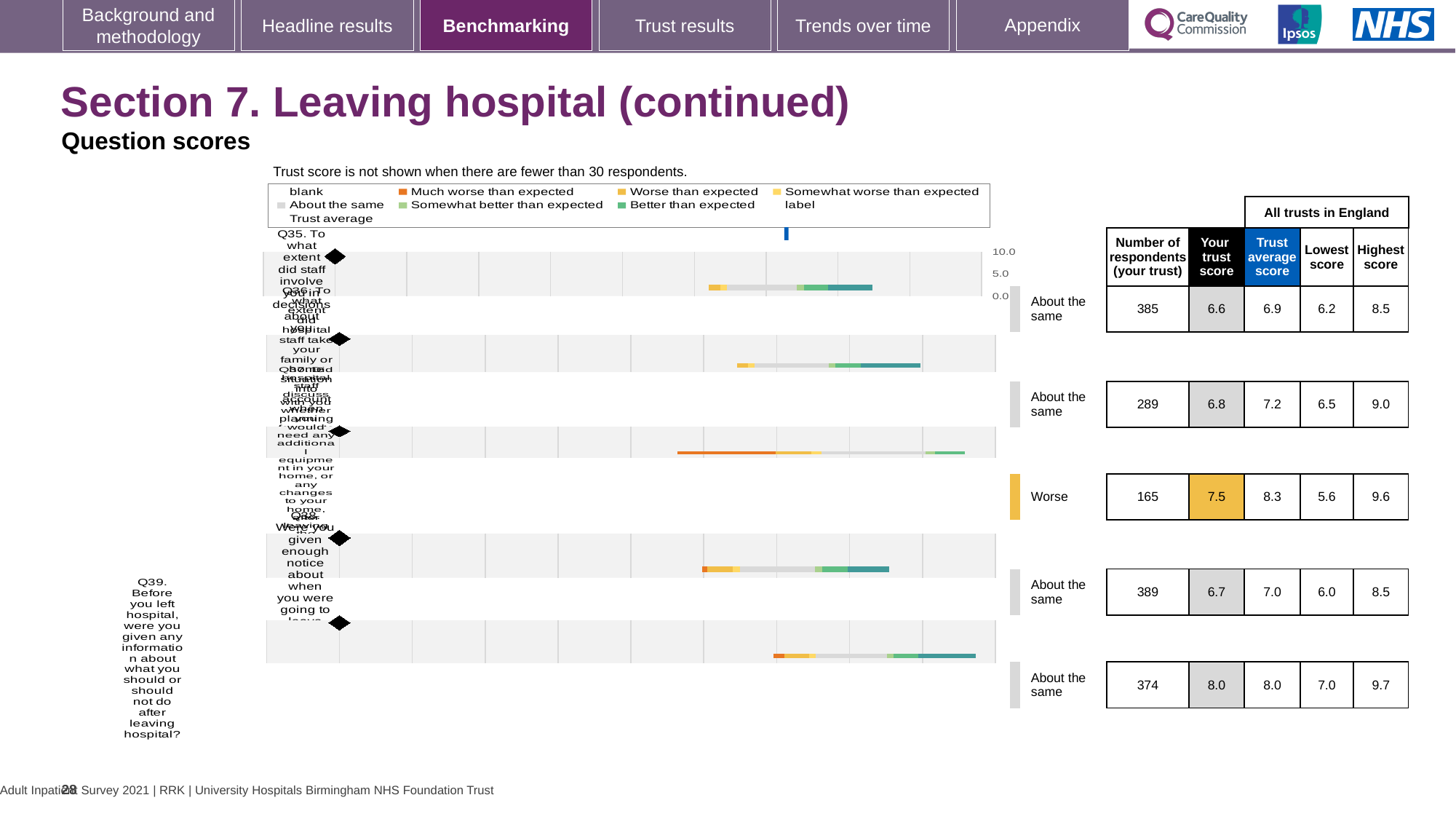
What is the lowest score across all trusts in England for the second row? 6.5 What kind of chart is used to show the question scores on this slide? bar chart Is the trust score for the first row (Q35) larger or smaller than the trust average score for that row? smaller What is the number of respondents for the first row (Q35) in the table? 385 How many rows are rated 'About the same'? 4 How many questions (rows) are shown in the question scores chart and table? 5 What is the trust average score for the third row, which is rated 'Worse'? 8.3 What is the trust score for the last row (Q39, information about what you should or should not do after leaving hospital)? 8.0 Which row has the highest 'Highest score' value? the last row (Q39), 9.7 What colour is the 'Your trust score' cell for the row rated 'Worse'? yellow/orange What is the difference between the trust average score and your trust score for the third row (rated 'Worse')? 0.8 Which row has the lowest number of respondents? the third row (165 respondents)